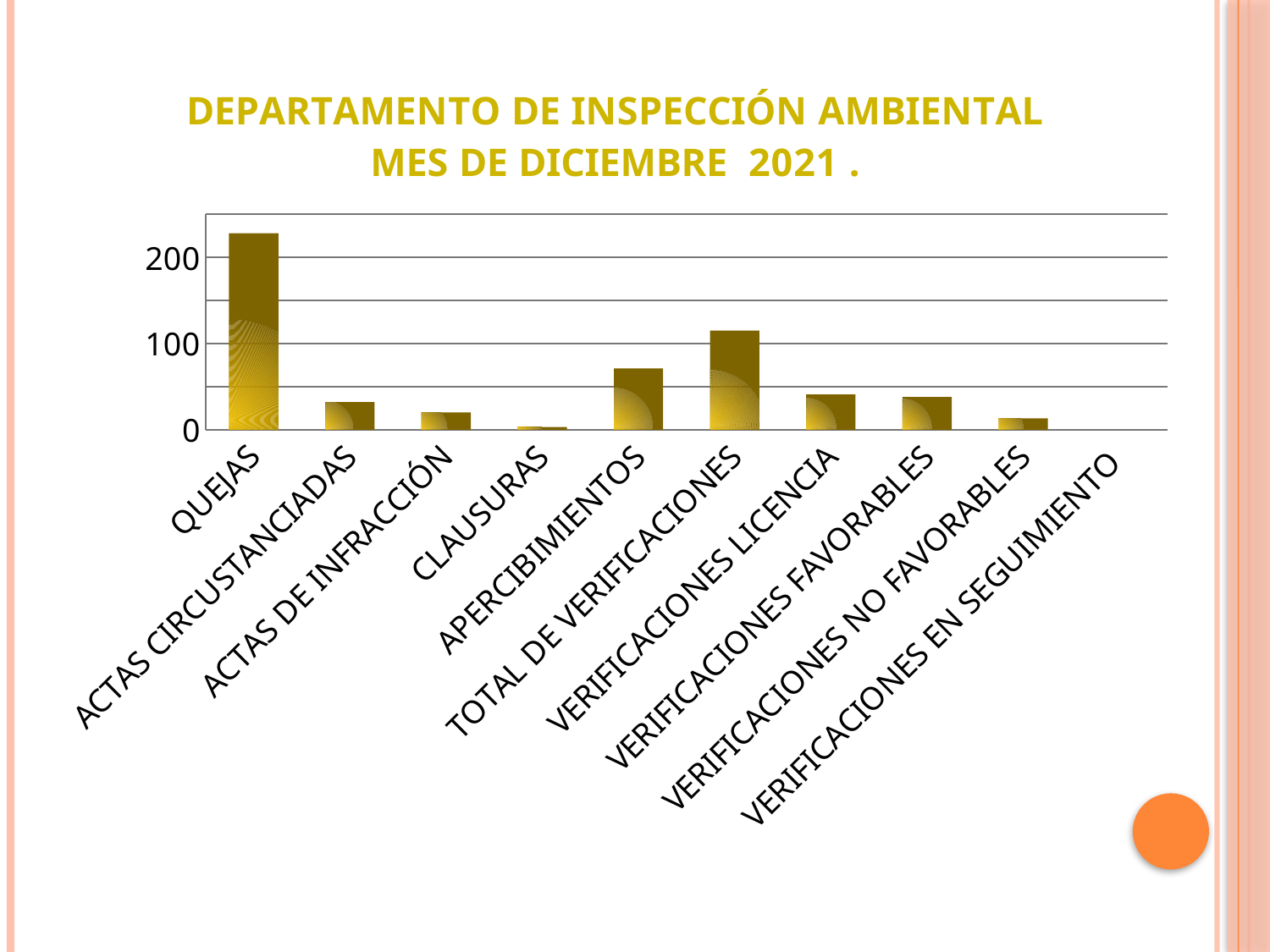
What is the title shown above the chart? DEPARTAMENTO DE INSPECCIÓN AMBIENTAL MES DE DICIEMBRE 2021 . Is the value for APERCIBIMIENTOS greater or less than 100? less Is the value for TOTAL DE VERIFICACIONES greater or less than 100? greater What kind of chart is shown on the slide? bar chart Which is larger, the value for APERCIBIMIENTOS or the value for ACTAS DE INFRACCIÓN? APERCIBIMIENTOS Is the value for QUEJAS greater or less than 200? greater Which is larger, the value for QUEJAS or the value for TOTAL DE VERIFICACIONES? QUEJAS How many categories are shown on the x axis of the chart? 10 What is the highest value labelled on the vertical axis of the chart? 200 Which is larger, the value for TOTAL DE VERIFICACIONES or the value for APERCIBIMIENTOS? TOTAL DE VERIFICACIONES Which category has the highest bar in the chart? QUEJAS